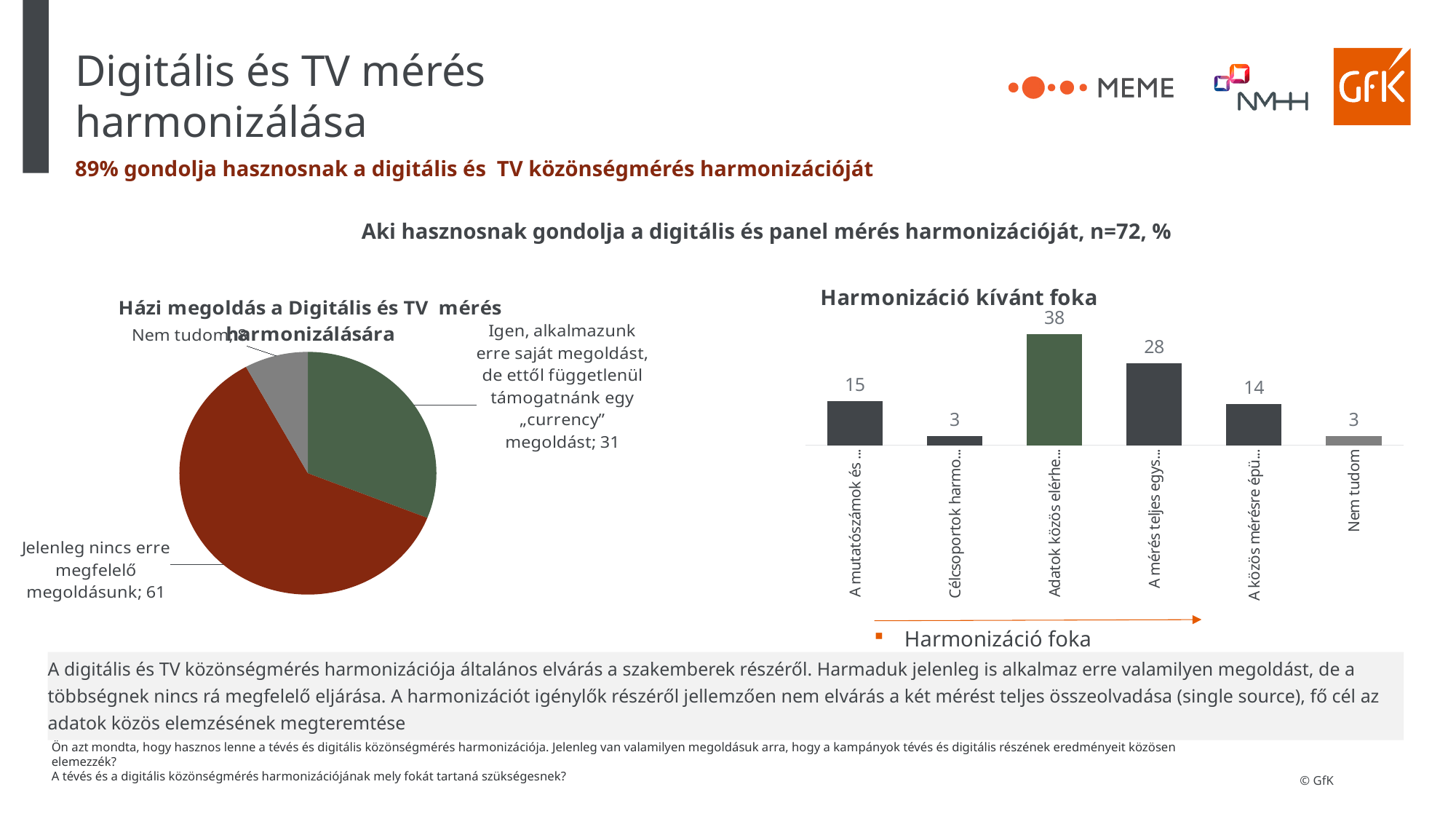
How many bars does the "Harmonizáció kívánt foka" chart have? 6 In the "Harmonizáció kívánt foka" chart, what is the highest value shown? 38 In the "Harmonizáció kívánt foka" chart, what is the value for "Nem tudom"? 3 In the "Harmonizáció kívánt foka" chart, which is larger: the fourth bar from the left or the fifth bar from the left? The fourth bar (28) In the pie chart, what is the value for "Jelenleg nincs erre megfelelő megoldásunk"? 61 In the pie chart, what is the value for the slice "Igen, alkalmazunk erre saját megoldást, de ettől függetlenül támogatnánk egy „currency” megoldást"? 31 What kind of chart is "Harmonizáció kívánt foka"? Bar chart How many slices does the pie chart have? 3 In the pie chart, what is the difference between the "Jelenleg nincs erre megfelelő megoldásunk" slice and the "Igen, alkalmazunk erre saját megoldást..." slice? 30 In the pie chart, which slice is the largest? Jelenleg nincs erre megfelelő megoldásunk In the "Harmonizáció kívánt foka" chart, what is the difference between the third bar (38) and the fourth bar (28)? 10 What kind of chart is the chart on the left of the slide? Pie chart